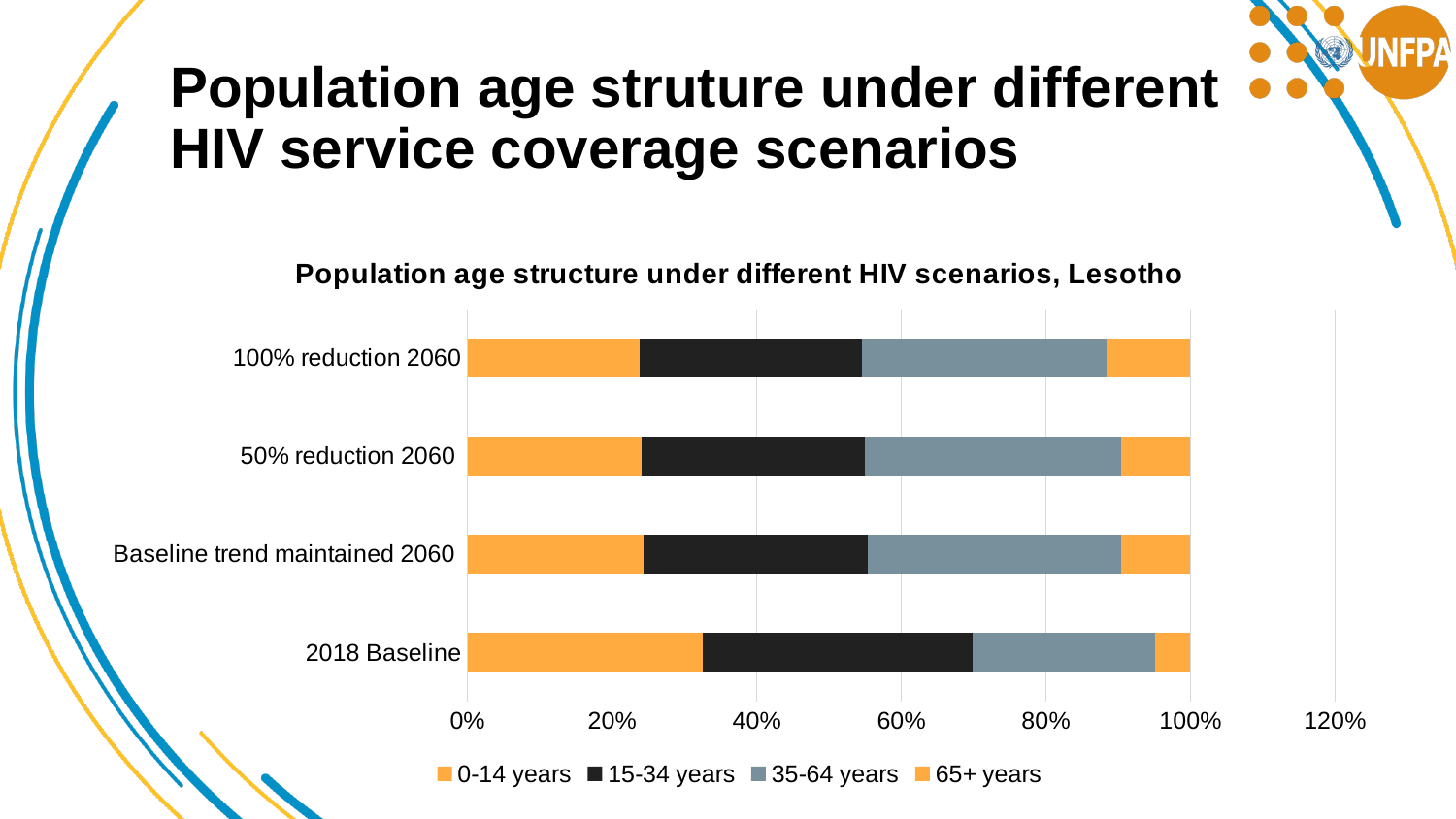
How many series does the legend list? 4 What kind of chart is shown on the slide? Stacked bar chart What is the title of the chart? Population age structure under different HIV scenarios, Lesotho Is the 0-14 years share for 2018 Baseline greater or less than 20%? greater Which age group is shown in black in the legend? 15-34 years Which has the larger 35-64 years share, 2018 Baseline or 50% reduction 2060? 50% reduction 2060 What is the total of the stacked bar for 2018 Baseline? 100% Which scenario has the largest 0-14 years share? 2018 Baseline How many scenario categories are plotted on the chart? 4 Is the 0-14 years share for 2018 Baseline greater or less than 40%? less Which scenario has the smallest 65+ years share? 2018 Baseline Is the 0-14 years share for 100% reduction 2060 greater or less than 20%? greater